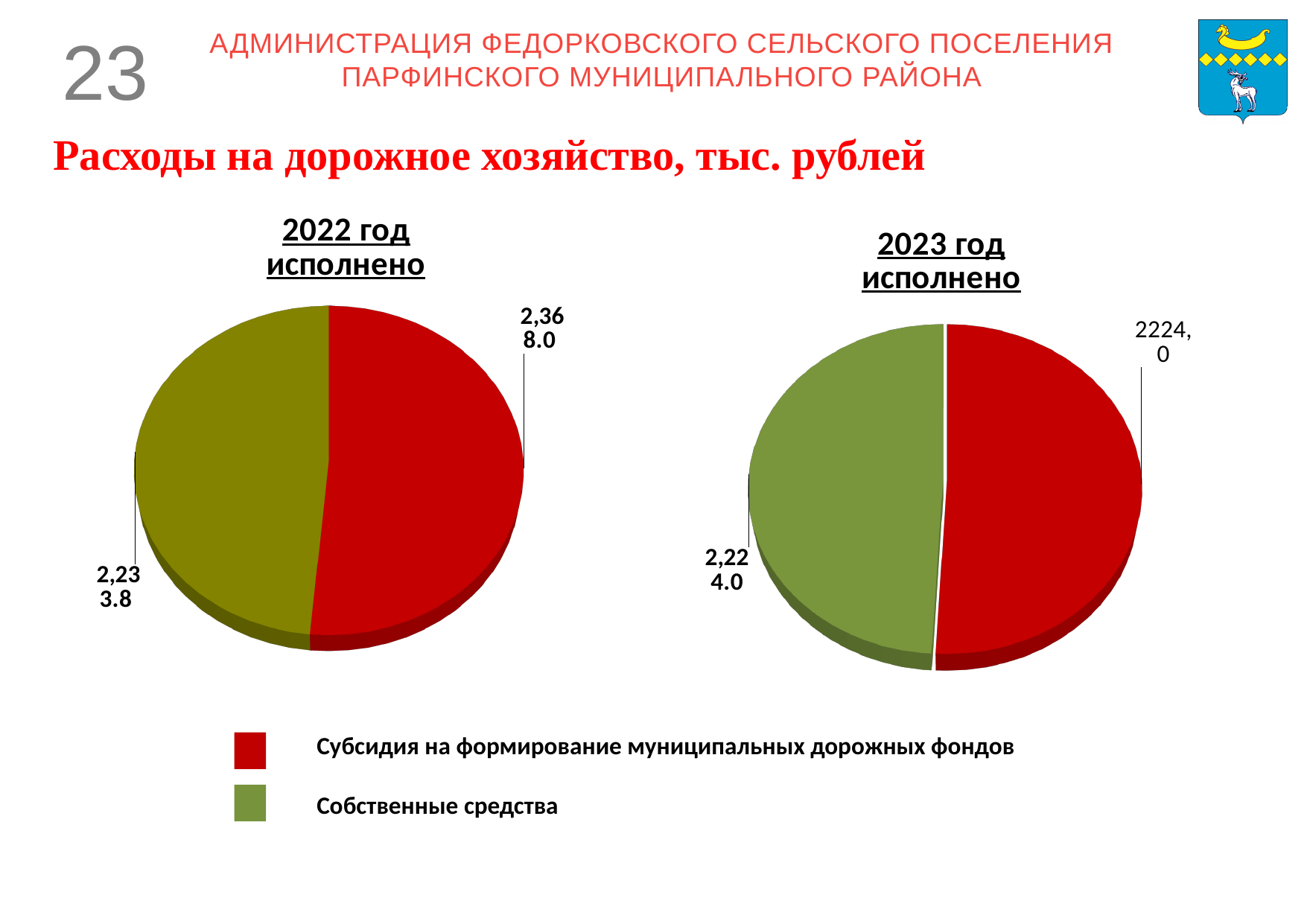
In the "2022 год исполнено" chart, what is the value for Собственные средства? 2,233.8 How many entries does the shared legend list? 2 In the "2023 год исполнено" chart, what is the value for Субсидия на формирование муниципальных дорожных фондов? 2224,0 What type of chart is used for the "2022 год исполнено" chart? pie chart In the "2022 год исполнено" chart, which category has the smallest value? Собственные средства In the "2023 год исполнено" chart, what is the value for Собственные средства? 2,224.0 How many slices does the "2023 год исполнено" pie chart have? 2 In the "2022 год исполнено" chart, what is the difference between the value for Субсидия на формирование муниципальных дорожных фондов and the value for Собственные средства? 134.2 In the "2022 год исполнено" chart, which is larger: Субсидия на формирование муниципальных дорожных фондов or Собственные средства? Субсидия на формирование муниципальных дорожных фондов In the legend, which colour represents Собственные средства? green In the "2022 год исполнено" chart, which category has the largest value? Субсидия на формирование муниципальных дорожных фондов In the "2022 год исполнено" chart, what is the value for Субсидия на формирование муниципальных дорожных фондов? 2,368.0